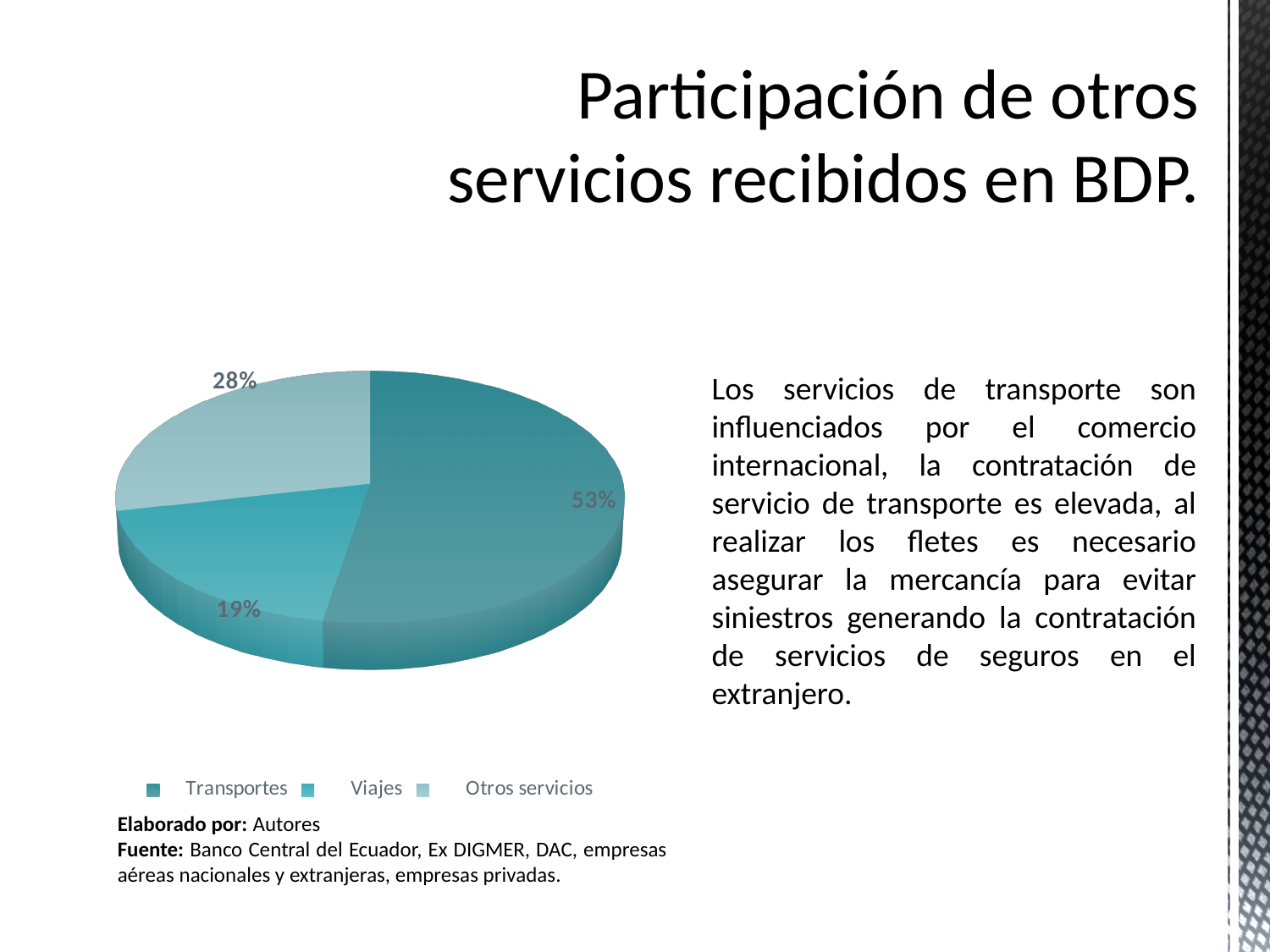
What share of the pie does Transportes have? 53% What share of the pie does Viajes have? 19% What kind of chart is shown on the slide? pie chart Which category is shown in the lightest colour in the pie chart? Otros servicios What is the difference in percentage points between Otros servicios and Viajes? 9 How many entries does the legend list? 3 What share of the pie does Otros servicios have? 28% What is the difference in percentage points between Transportes and Otros servicios? 25 Which is larger, the share for Viajes or the share for Otros servicios? Otros servicios How many slices does the pie chart have? 3 Which category has the largest slice of the pie? Transportes Which category has the smallest slice of the pie? Viajes